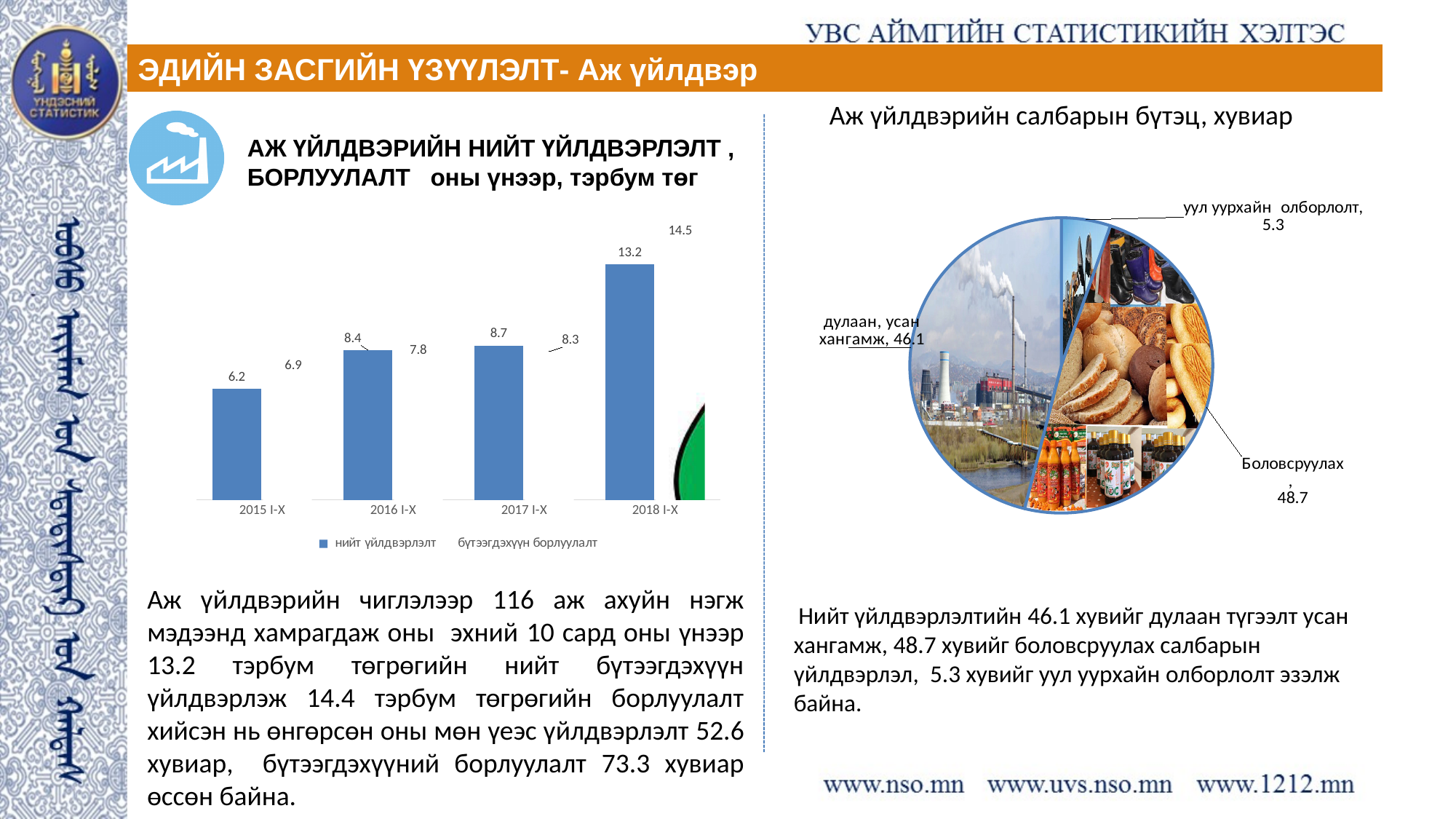
In the bar chart on the left, what is the value of нийт үйлдвэрлэлт for 2016 I-X? 8.4 In the bar chart on the left, which period has the lowest value of бүтээгдэхүүн борлуулалт? 2015 I-X In the bar chart on the left, what is the difference between the нийт үйлдвэрлэлт values for 2018 I-X and 2017 I-X? 4.5 In the bar chart on the left, does нийт үйлдвэрлэлт rise or fall from 2015 I-X to 2018 I-X? rise In the pie chart titled 'Аж үйлдвэрийн салбарын бүтэц, хувиар', which sector has the smallest share? уул уурхайн олборлолт In the pie chart titled 'Аж үйлдвэрийн салбарын бүтэц, хувиар', what is the share of Боловсруулах? 48.7 In the bar chart on the left, how many series does the legend list? 2 In the bar chart on the left, which is larger for 2018 I-X: нийт үйлдвэрлэлт or бүтээгдэхүүн борлуулалт? бүтээгдэхүүн борлуулалт In the bar chart on the left, what is the value of бүтээгдэхүүн борлуулалт for 2015 I-X? 6.9 In the bar chart on the left, what is the value of нийт үйлдвэрлэлт for 2018 I-X? 13.2 In the bar chart on the left, how many periods are shown on the x axis? 4 In the bar chart on the left, which period has the highest value of нийт үйлдвэрлэлт? 2018 I-X